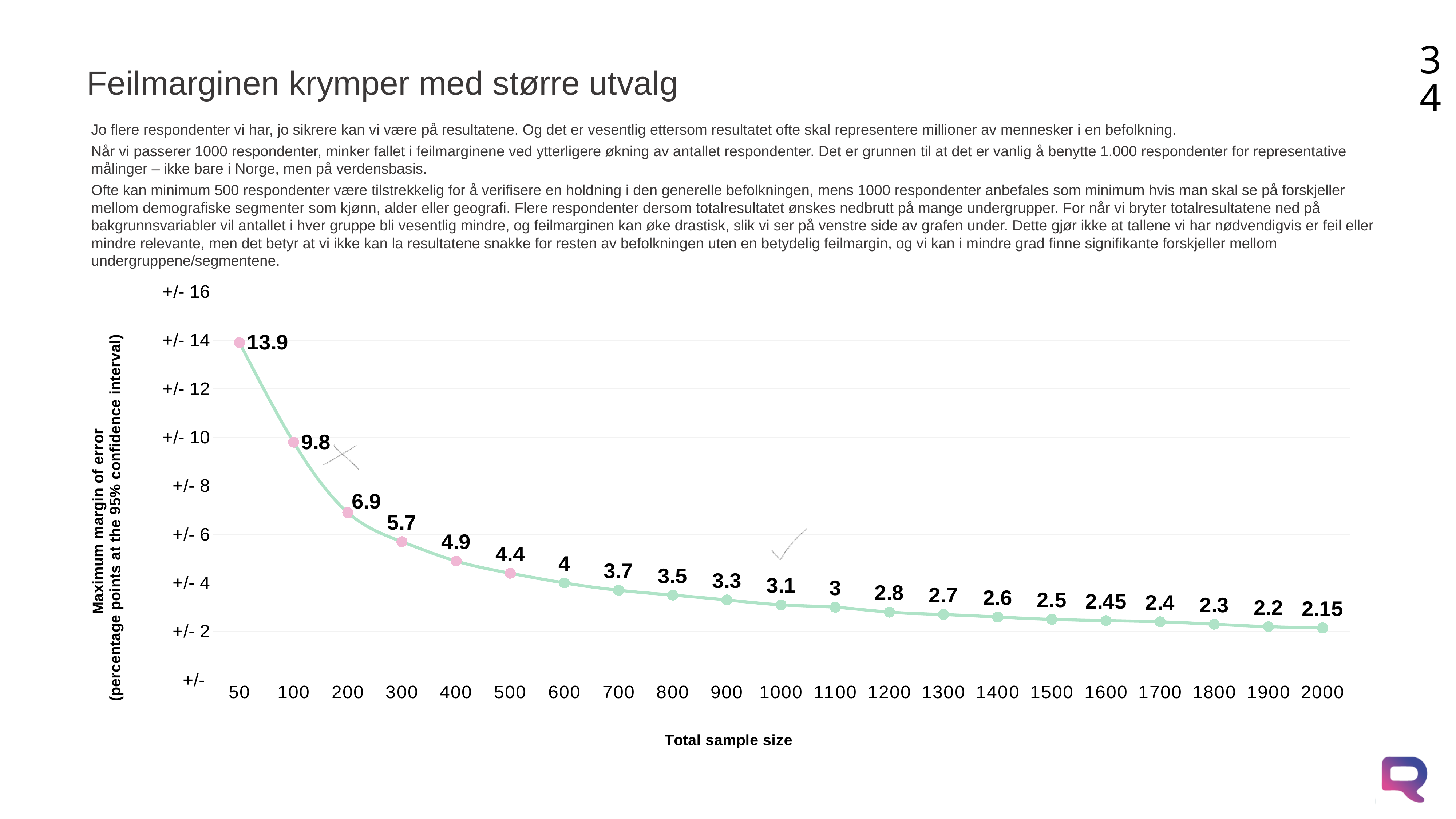
What is the maximum margin of error for a total sample size of 2000? 2.15 Which total sample size has the lowest maximum margin of error? 2000 How many total sample size points are plotted on the chart? 21 What is the maximum margin of error for a total sample size of 50? 13.9 Does the maximum margin of error rise or fall as the total sample size increases? Fall Which total sample size has the highest maximum margin of error? 50 Which has a larger margin of error: a sample size of 300 or a sample size of 600? 300 What is the maximum margin of error for a total sample size of 500? 4.4 What is the label of the x axis of the chart? Total sample size What is the maximum margin of error for a total sample size of 1000? 3.1 What kind of chart is shown on the slide? Line chart What is the difference between the margin of error at a sample size of 100 and at a sample size of 200? 2.9